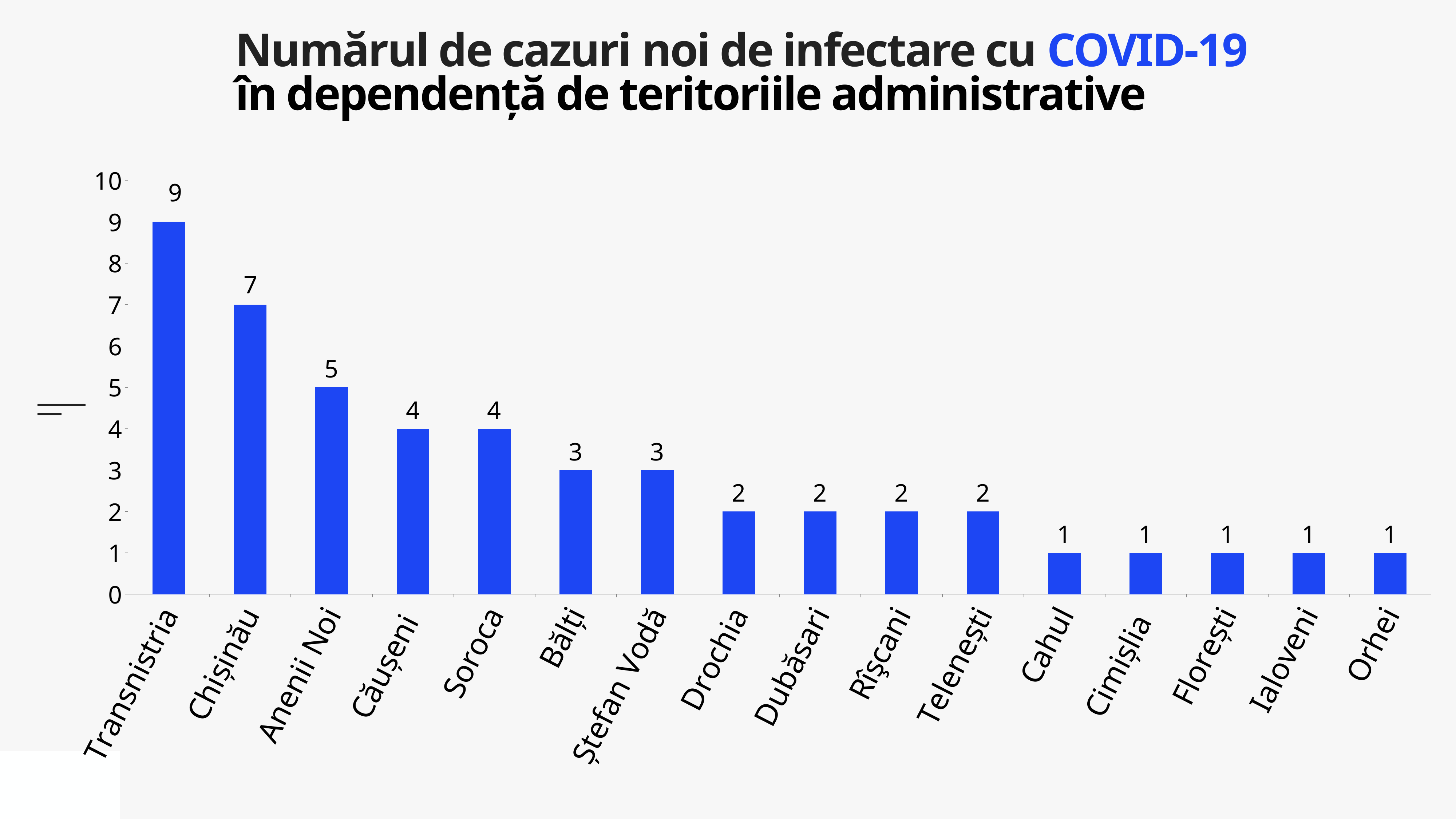
How many categories are shown on the x axis? 16 Which category has the highest value? Transnistria What kind of chart is shown on the slide? bar chart Is the value for Chișinău greater or less than 5? greater Do the values rise or fall from left to right along the x axis? fall What is the value for Transnistria? 9 What is the difference between the values for Transnistria and Chișinău? 2 What is the value for Chișinău? 7 What is the value for Bălți? 3 What is the value for Anenii Noi? 5 Which is larger, the value for Căușeni or the value for Telenești? Căușeni What is the difference between the values for Anenii Noi and Drochia? 3